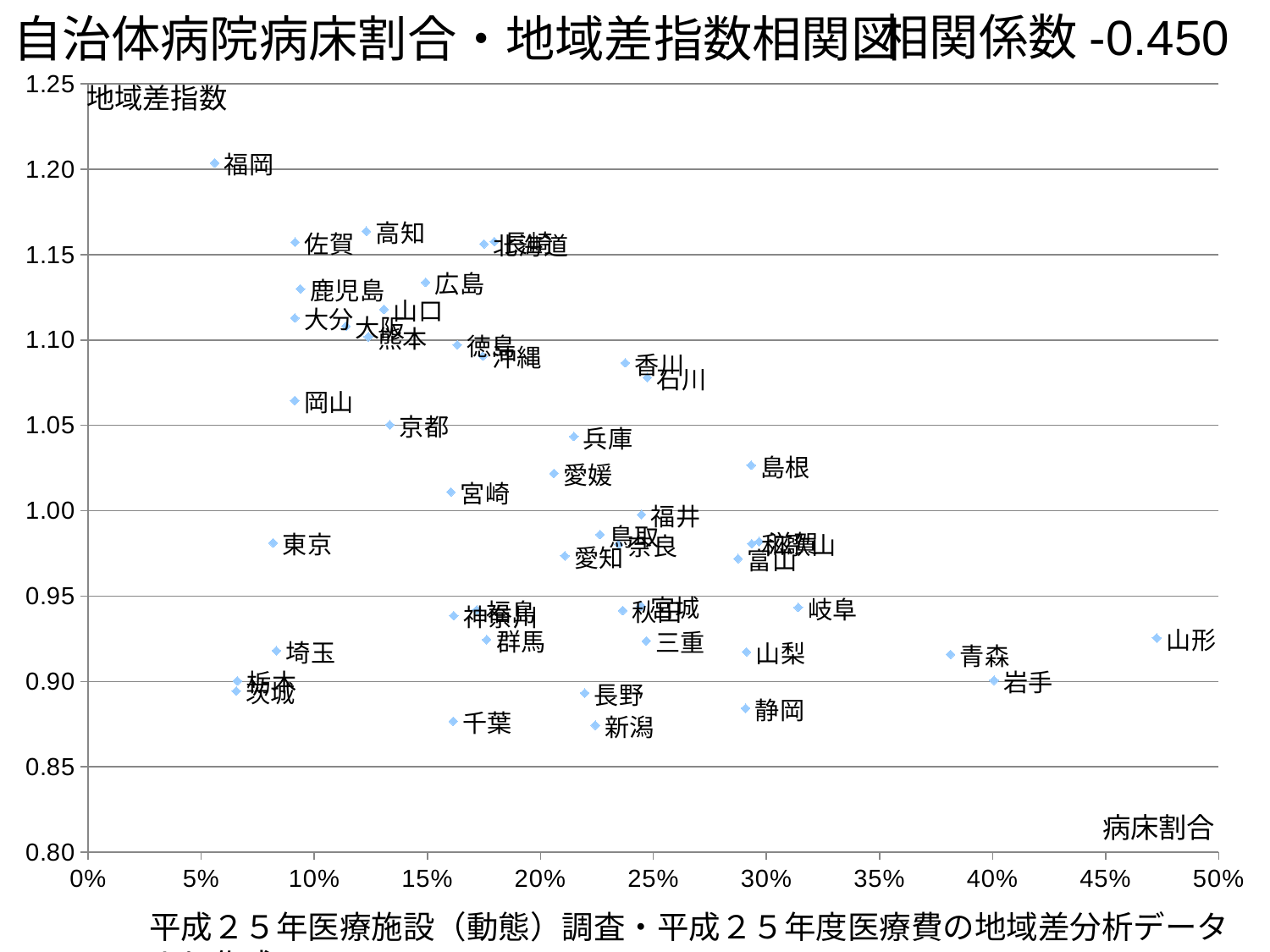
Is the 病床割合 for 山形 greater or less than 45%? greater What kind of chart is shown on the slide? scatter chart Is the 地域差指数 for 静岡 greater or less than 0.90? less Which prefecture has the highest 地域差指数 on the chart? 福岡 Which has the higher 地域差指数, 福岡 or 東京? 福岡 As 病床割合 increases along the x axis, does 地域差指数 tend to rise or fall? fall Which prefecture has the highest 病床割合 on the chart? 山形 What correlation coefficient (相関係数) is shown in the chart title? -0.450 Which has the higher 地域差指数, 島根 or 山梨? 島根 Which has the larger 病床割合, 岩手 or 埼玉? 岩手 Is the 地域差指数 for 高知 greater or less than 1.15? greater